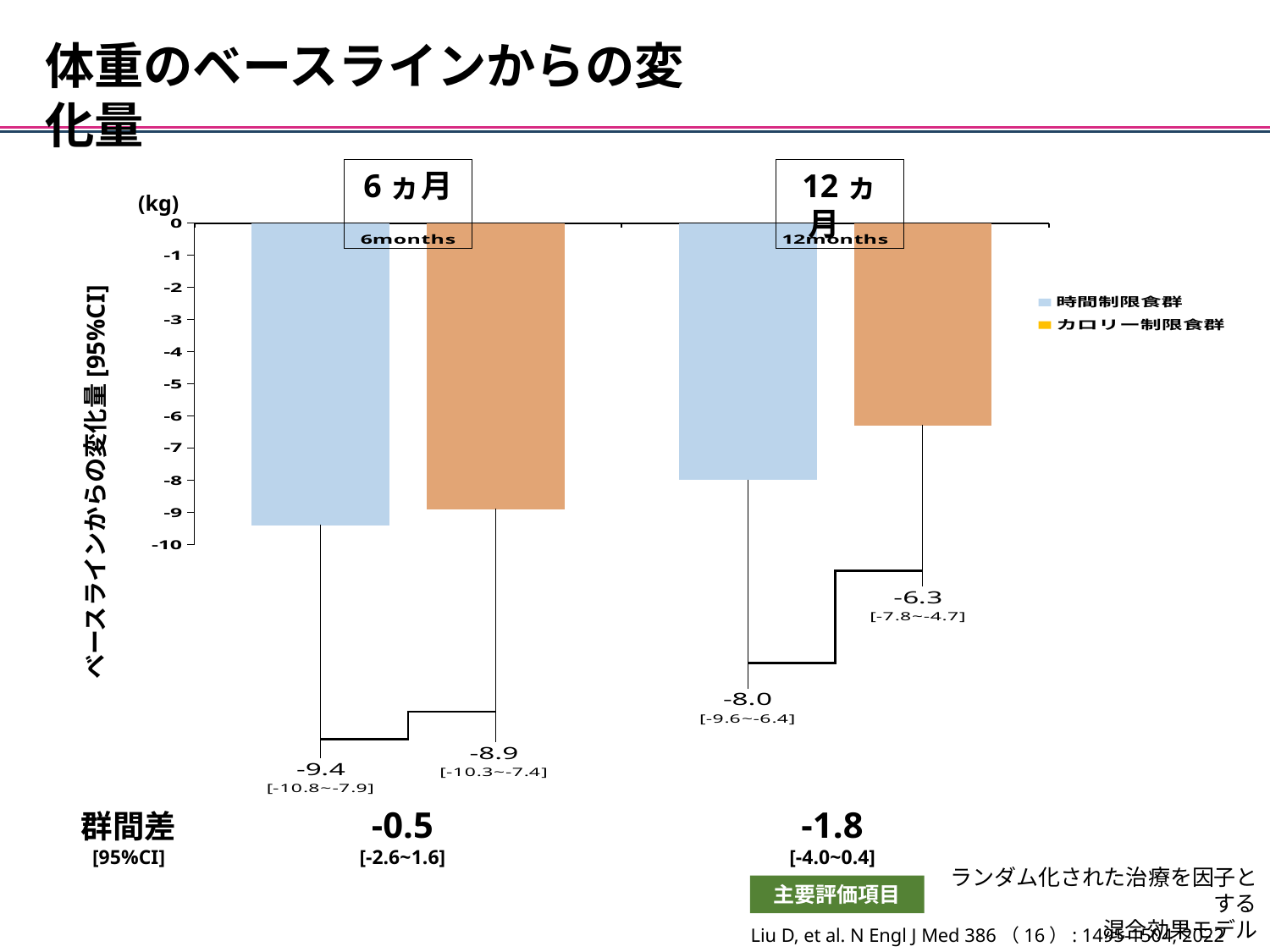
What is the change from baseline in body weight for the 時間制限食群 at 6 months? -9.4 What is the change from baseline in body weight for the カロリー制限食群 at 12 months? -6.3 What is the 95% confidence interval shown for the 時間制限食群 value at 12 months? [-9.6~-6.4] Which bar shows the largest weight loss (most negative value)? 時間制限食群 at 6 months What is the between-group difference (群間差) shown at 12 months? -1.8 How many series does the legend list? 2 What is the change from baseline for the 時間制限食群 at 12 months? -8.0 Which bar shows the smallest weight loss (least negative value)? カロリー制限食群 at 12 months At 12 months, which group has the larger weight reduction, 時間制限食群 or カロリー制限食群? 時間制限食群 What is the difference between the 時間制限食群 and カロリー制限食群 values at 12 months? 1.7 What is the change from baseline for the カロリー制限食群 at 6 months? -8.9 What kind of chart is shown on the slide? Bar chart